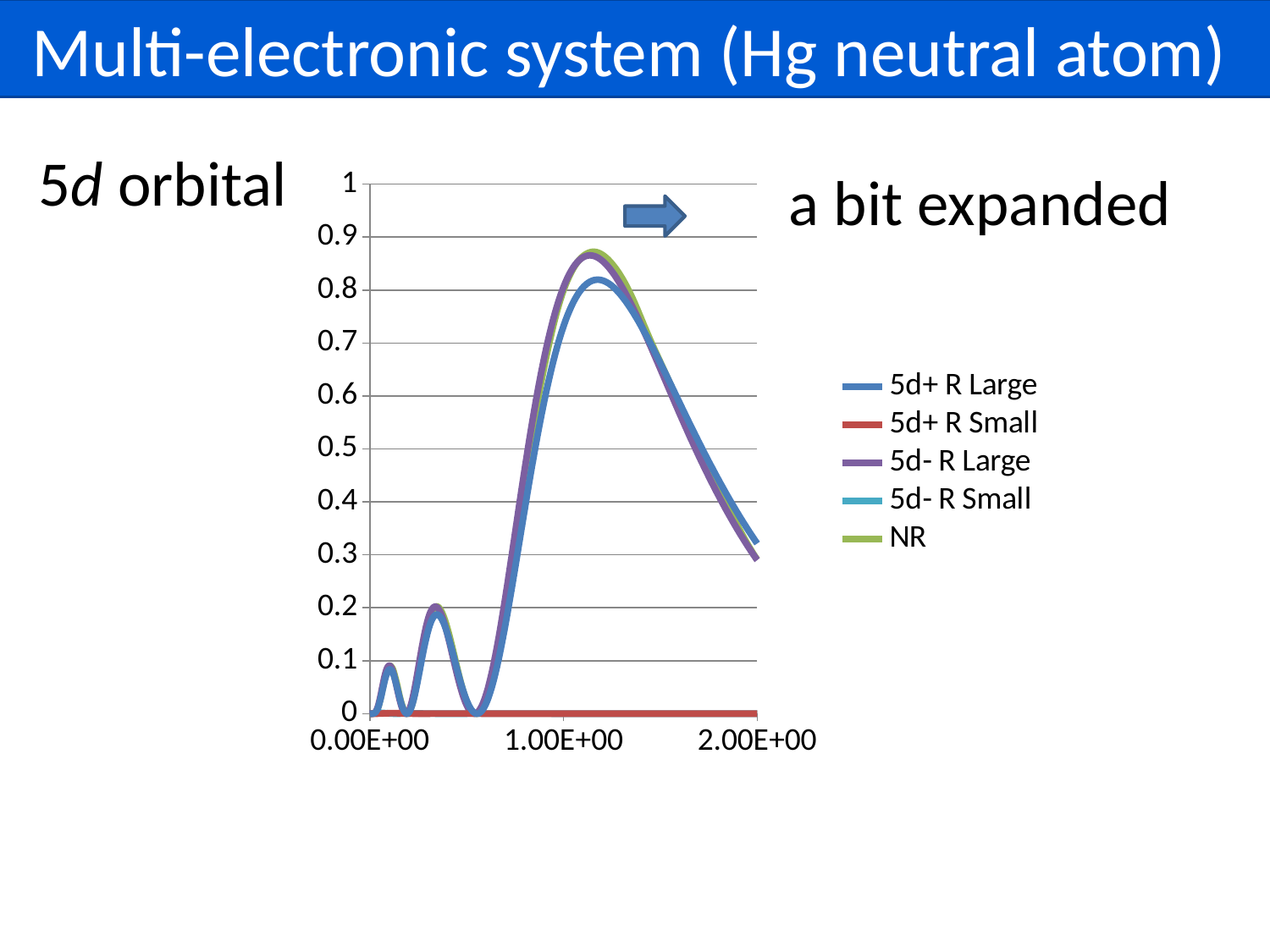
Is the peak value of the NR series greater or less than 0.8? greater What kind of chart is shown on the slide? line chart Which series reaches a higher peak, NR or 5d+ R Large? NR How many series does the chart legend list? 5 Do the values of the 5d+ R Large series rise or fall between 1.50E+00 and 2.00E+00 on the x axis? fall Which series is listed first in the chart legend? 5d+ R Large What is the highest tick value shown on the y axis? 1 Is the value of the 5d+ R Small series at 1.00E+00 greater or less than 0.1? less How many tick labels are shown on the x axis? 3 Is the peak value of the NR series greater or less than 0.9? less Which series is listed last in the chart legend? NR